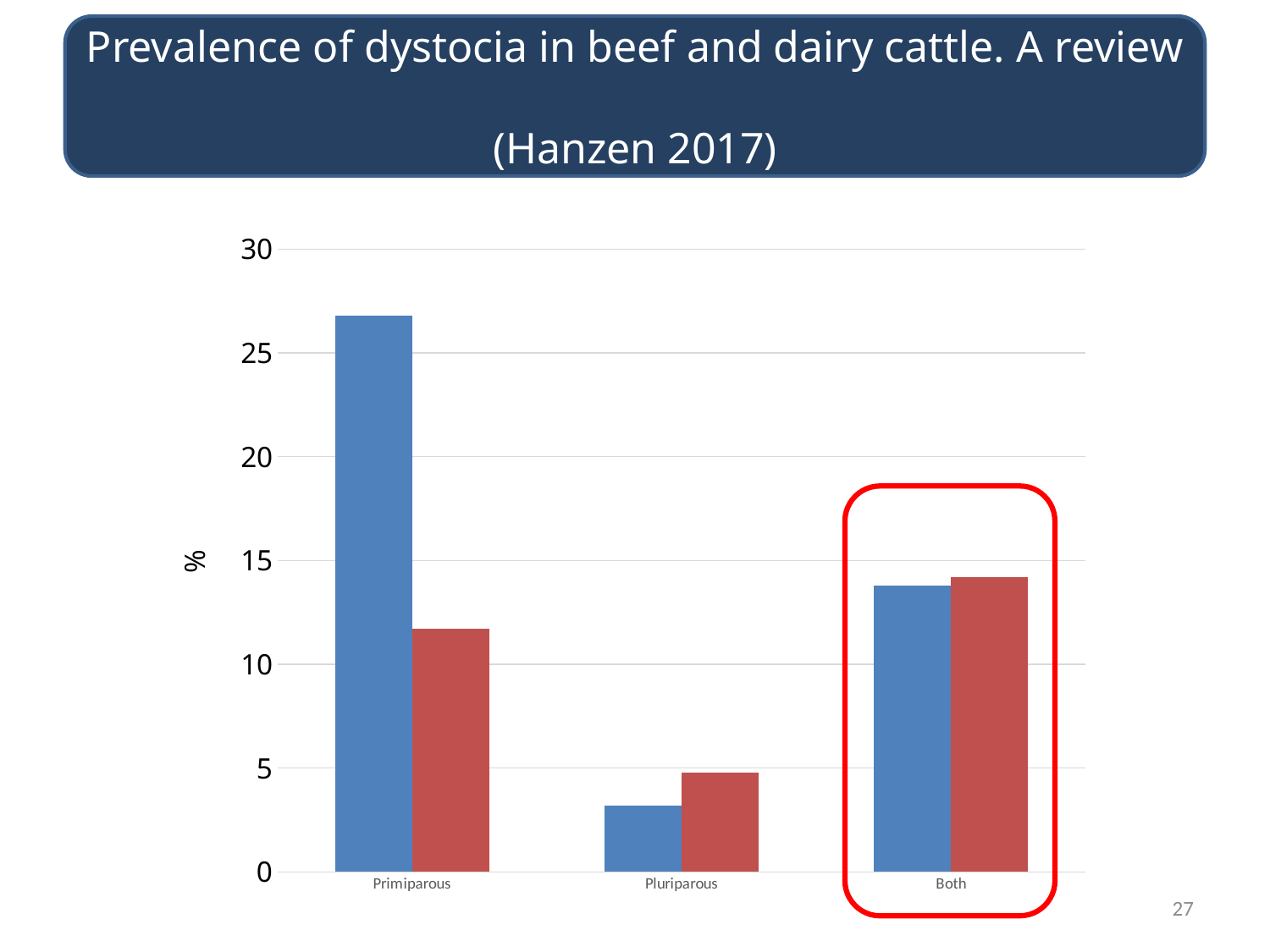
For Pluriparous, which bar is taller, the blue bar or the red bar? the red bar Is the value of the red bar for Primiparous greater or less than 10? greater Which category on the chart is highlighted with a red outline? Both How many bars are plotted for each category in the chart? 2 Is the value of the blue bar for Both greater or less than 15? less Is the value of the blue bar for Primiparous greater or less than 25? greater Which category has the shortest bar in the chart? Pluriparous Which category has the tallest bar in the chart? Primiparous What kind of chart is shown on the slide? bar chart How many categories are shown on the x axis of the chart? 3 For Primiparous, which bar is taller, the blue bar or the red bar? the blue bar